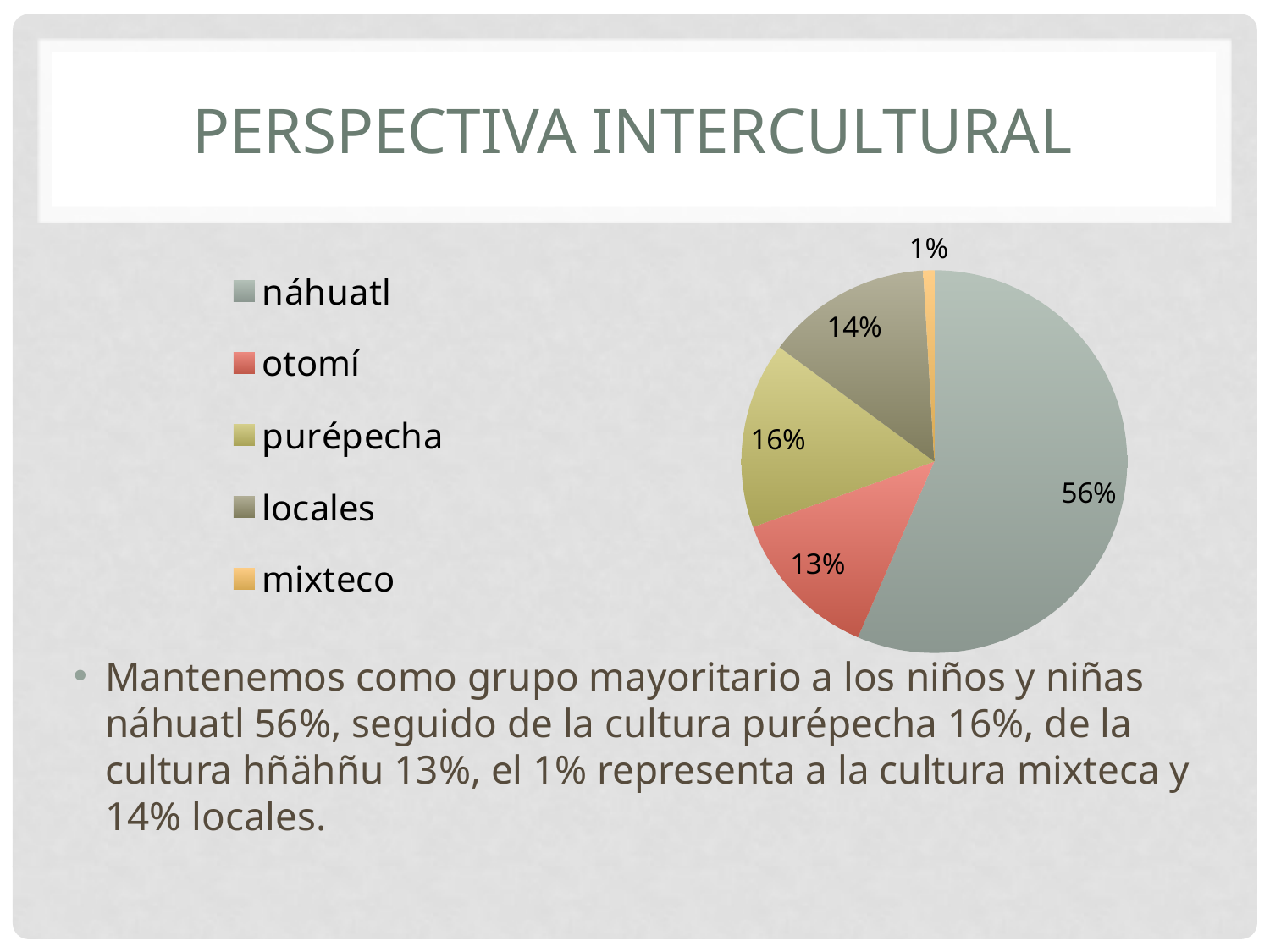
What share of the pie does otomí represent? 13% Which category has the largest slice of the pie? náhuatl What share of the pie does purépecha represent? 16% Which category has the smallest slice of the pie? mixteco What share of the pie does locales represent? 14% What kind of chart is shown on the slide? pie chart How many categories does the pie chart show? 5 Which category is shown in orange in the legend? mixteco What is the difference in percentage points between the náhuatl slice and the purépecha slice? 40 Which slice is larger, purépecha or locales? purépecha